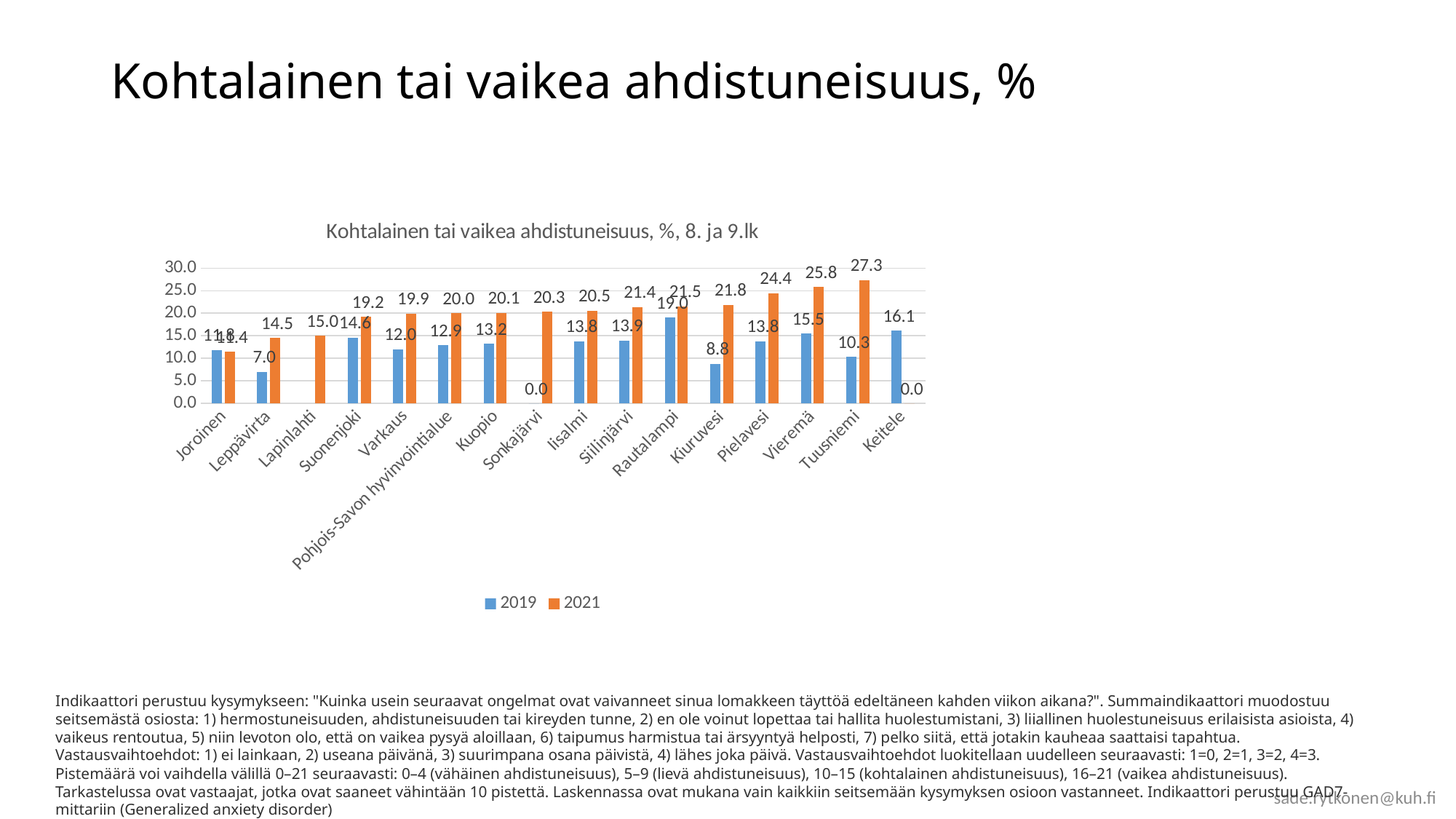
What are the two entries in the legend? 2019 and 2021 What is the 2019 value for Leppävirta? 7.0 Which category has the highest 2019 value? Rautalampi What kind of chart is shown on the slide? bar chart What is the 2021 value for Tuusniemi? 27.3 How many categories are shown on the x axis? 16 Which category has the highest 2021 value? Tuusniemi What is the 2019 value for Keitele? 16.1 Which has the larger 2021 value, Vieremä or Pielavesi? Vieremä What is the difference between the 2021 and 2019 values for Kiuruvesi? 13.0 How many series does the legend list? 2 What is the 2021 value for Kuopio? 20.1